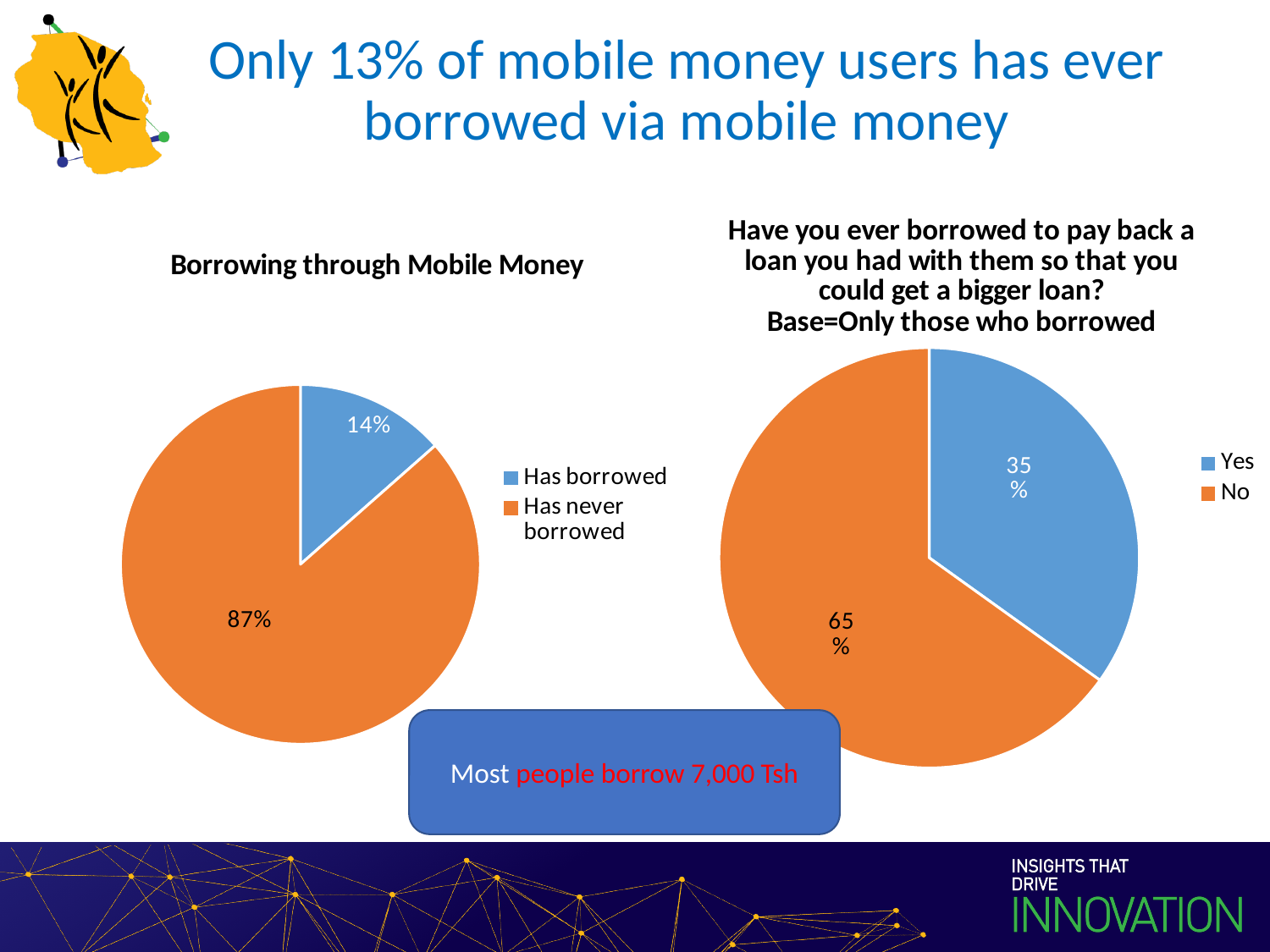
In the chart on the right ('Have you ever borrowed to pay back a loan...'), what share of the pie is 'Yes'? 35% In the 'Borrowing through Mobile Money' chart, what share of the pie is 'Has never borrowed'? 87% In the chart on the right ('Have you ever borrowed to pay back a loan...'), what colour is the 'Yes' slice? Blue In the 'Borrowing through Mobile Money' chart, what share of the pie is 'Has borrowed'? 14% What kind of chart is the 'Borrowing through Mobile Money' chart? Pie chart In the 'Borrowing through Mobile Money' chart, which category has the smallest slice? Has borrowed How many categories does the legend of the 'Borrowing through Mobile Money' chart list? 2 In the chart on the right ('Have you ever borrowed to pay back a loan...'), what share of the pie is 'No'? 65% In the 'Borrowing through Mobile Money' chart, which category has the largest slice? Has never borrowed In the chart on the right ('Have you ever borrowed to pay back a loan...'), which is larger, 'Yes' or 'No'? No In the 'Borrowing through Mobile Money' chart, what is the difference in percentage points between 'Has never borrowed' and 'Has borrowed'? 73 In the chart on the right ('Have you ever borrowed to pay back a loan...'), what is the difference in percentage points between 'No' and 'Yes'? 30